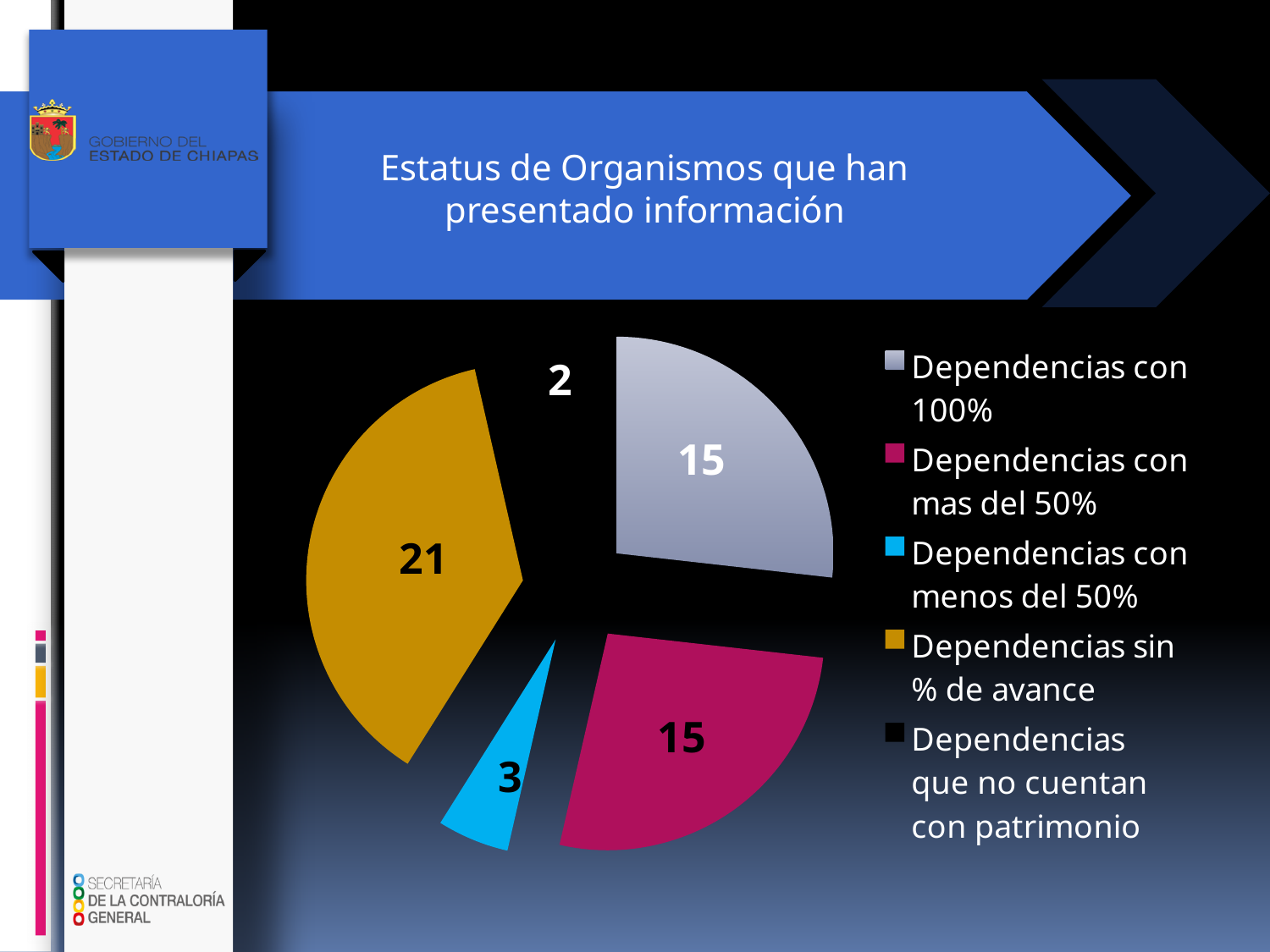
What share of the pie does "Dependencias sin % de avance" represent? 37.5% What is the difference between the values for "Dependencias sin % de avance" and "Dependencias con menos del 50%"? 18 What kind of chart is shown on the slide? pie chart Which is larger: the value for "Dependencias con mas del 50%" or the value for "Dependencias con menos del 50%"? Dependencias con mas del 50% What is the value for "Dependencias con menos del 50%"? 3 What is the value for "Dependencias que no cuentan con patrimonio"? 2 What is the value for "Dependencias con 100%"? 15 Which category has the smallest slice of the pie? Dependencias que no cuentan con patrimonio How many categories does the pie chart have? 5 What is the title of the chart on the slide? Estatus de Organismos que han presentado información Which category has the largest slice of the pie? Dependencias sin % de avance What is the value for "Dependencias sin % de avance"? 21